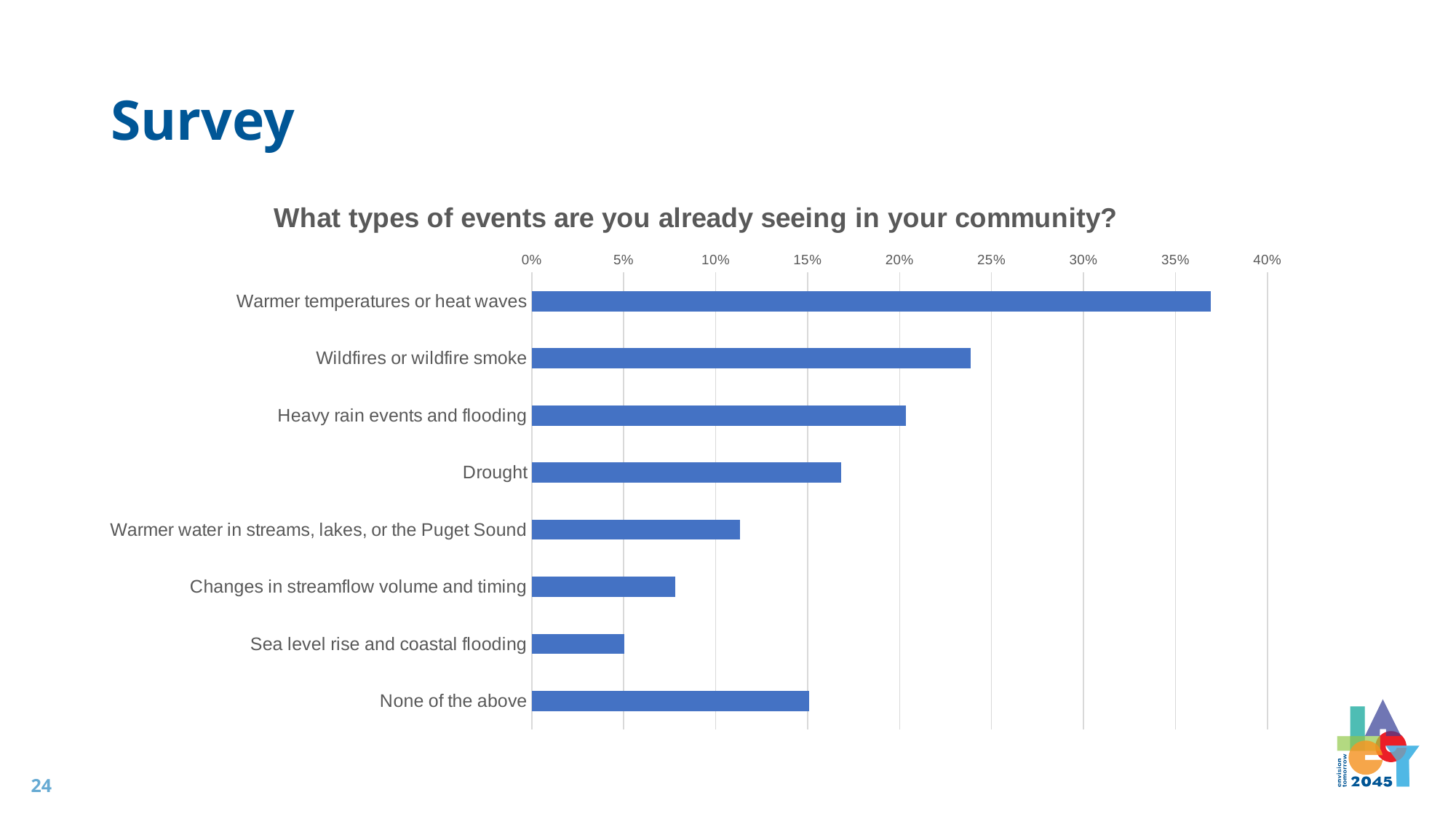
Which category has the highest value? Warmer temperatures or heat waves What is the title of the chart? What types of events are you already seeing in your community? Is the value for Wildfires or wildfire smoke greater or less than 20%? greater Which category has the lowest value? Sea level rise and coastal flooding Is the value for Changes in streamflow volume and timing greater or less than 10%? less Which is larger, the value for None of the above or the value for Warmer water in streams, lakes, or the Puget Sound? None of the above How many categories are shown in the chart? 8 What kind of chart is shown on the slide? bar chart Is the value for Drought greater or less than 15%? greater Which is larger, the value for Wildfires or wildfire smoke or the value for Heavy rain events and flooding? Wildfires or wildfire smoke